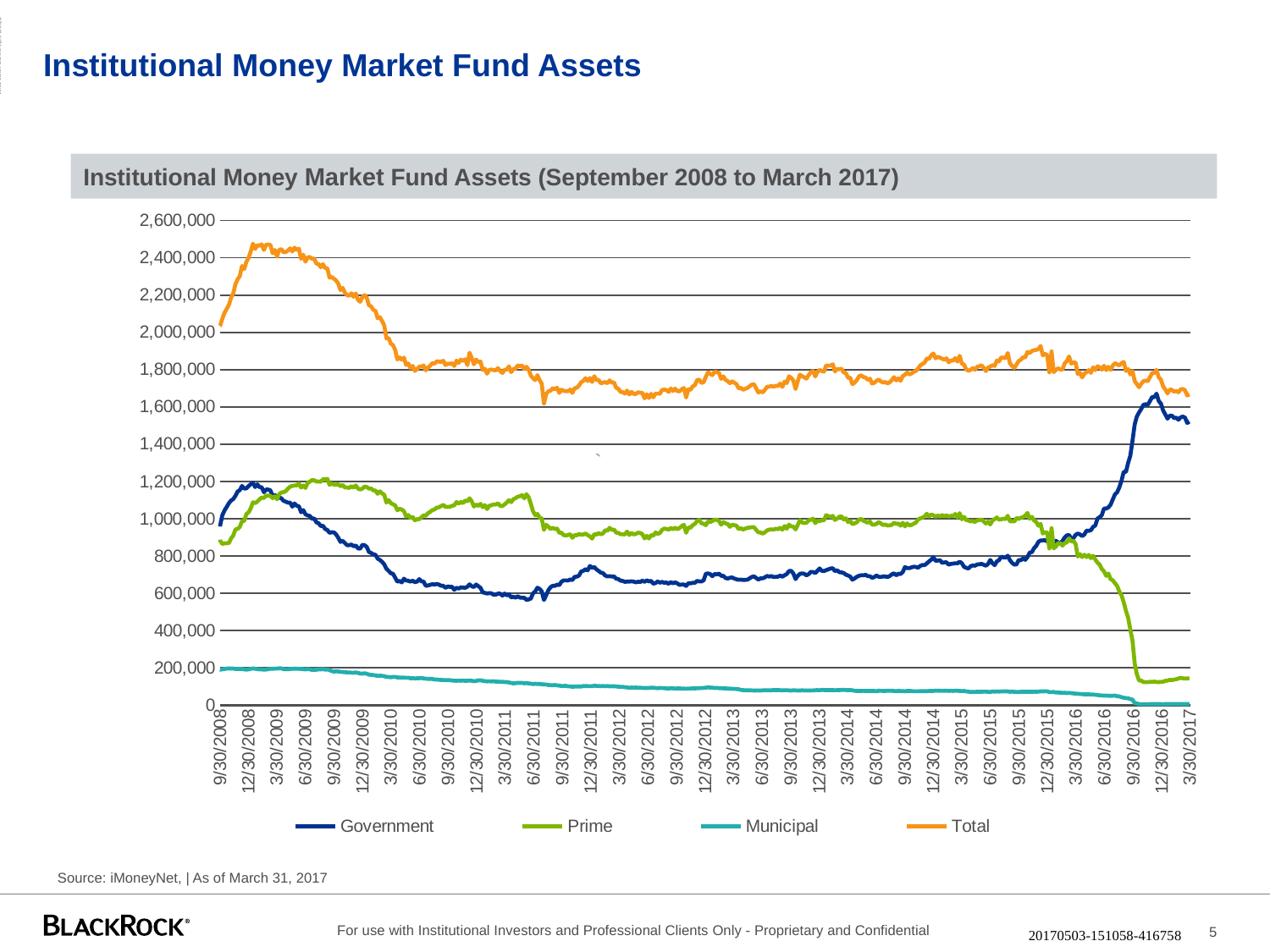
Is the value for Government at 3/30/2017 greater or less than 1,400,000? greater Is the value for Prime at 3/30/2017 greater or less than 400,000? less Is the peak value of the Total series around 12/30/2008 greater or less than 2,400,000? greater At 3/30/2017, which is larger, Government or Prime? Government How many series does the legend list? 4 What is the title of the chart? Institutional Money Market Fund Assets (September 2008 to March 2017) What are the series names listed in the legend? Government, Prime, Municipal, Total Does the Municipal series rise or fall from 9/30/2008 to 3/30/2017? fall Which series has the lowest values across the whole period? Municipal Which series has the highest values across the whole period? Total What kind of chart is shown on the slide? line chart